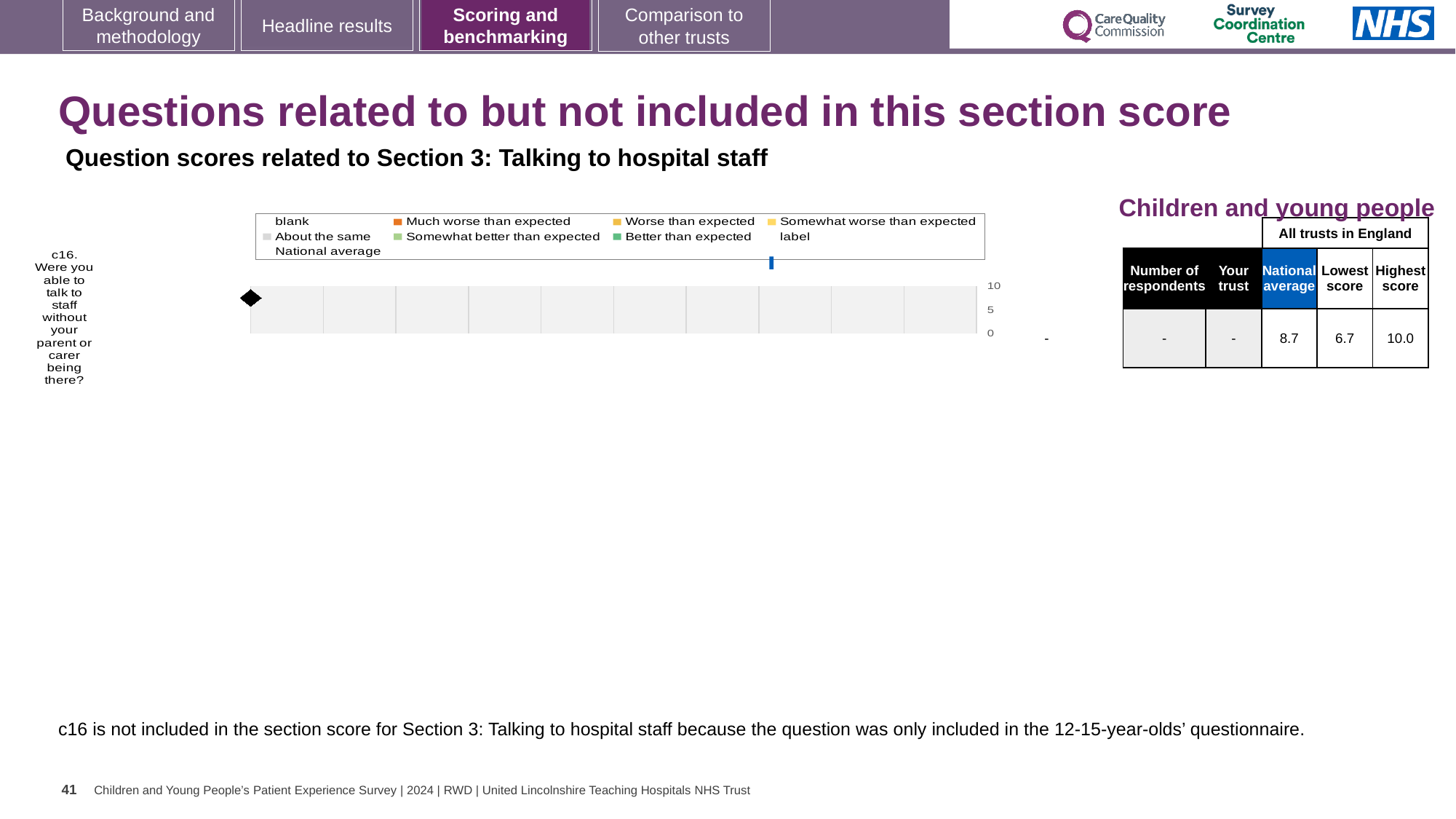
How many questions (categories) are plotted in the chart? 1 What kind of chart is shown on the slide? bar chart In the table next to the chart, what is the lowest score among all trusts in England for c16? 6.7 In the table next to the chart, what is the national average score for c16? 8.7 Is the national average score for c16 higher or lower than the lowest score? higher What is the difference between the highest score and the lowest score for c16 in the table? 3.3 What is the highest tick value shown on the chart's score axis? 10 In the table next to the chart, what is the highest score among all trusts in England for c16? 10.0 How many entries does the chart legend list? 9 Which question is plotted in the chart? c16. Were you able to talk to staff without your parent or carer being there?